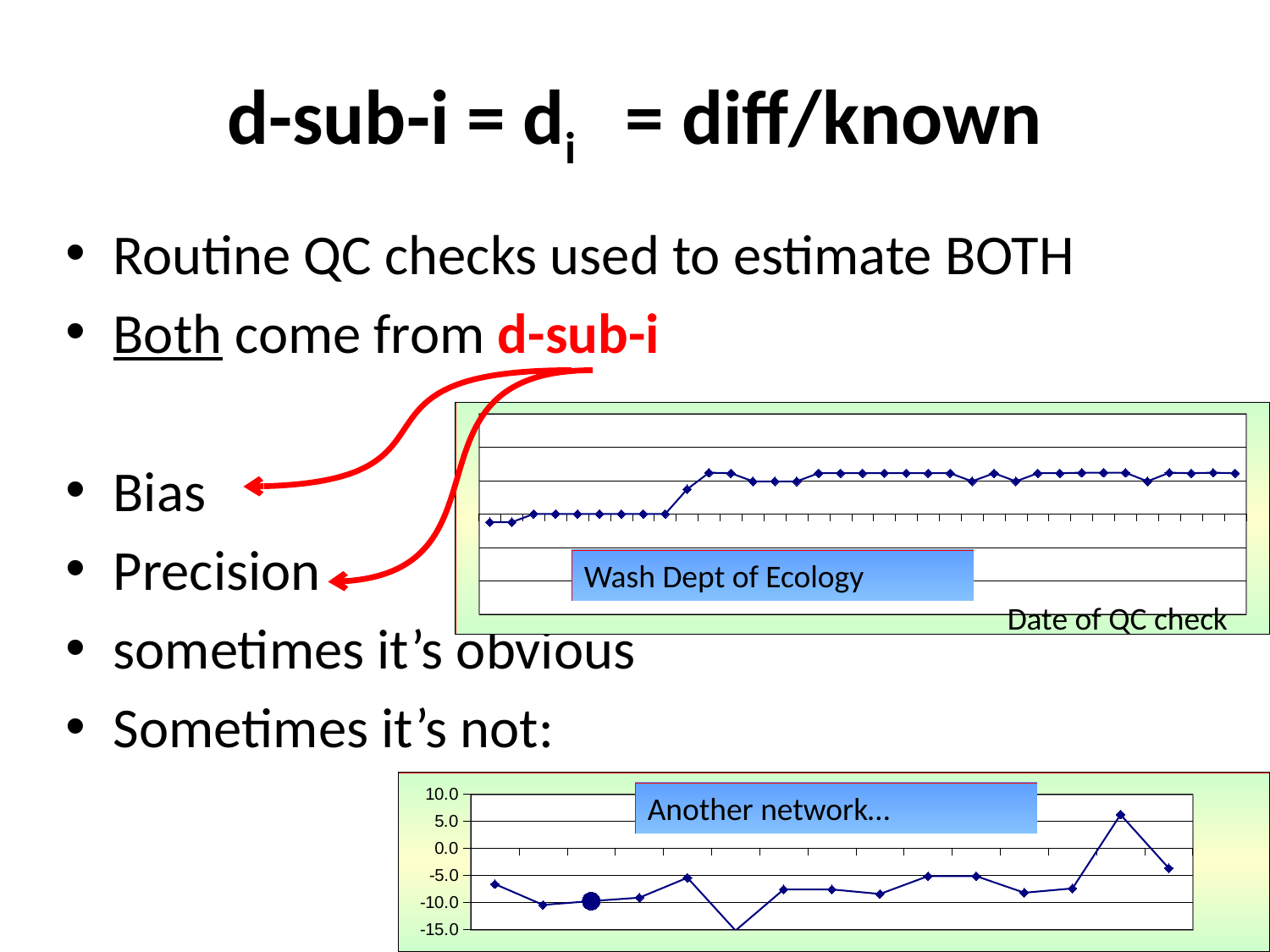
In the bottom chart labelled 'Another network...', how many plotted points are there? 15 In the bottom chart labelled 'Another network...', is the first plotted point greater or less than -5.0? less What text appears in the label box inside the bottom chart? Another network... In the bottom chart labelled 'Another network...', how many plotted points lie above 0.0? 1 In the top chart labelled 'Wash Dept of Ecology', do the plotted values rise or fall from left to right along the x axis? rise What kind of chart is the top chart labelled 'Wash Dept of Ecology'? line chart In the bottom chart labelled 'Another network...', is the last plotted point greater or less than 0.0? less What is the x-axis label of the top chart? Date of QC check In the bottom chart labelled 'Another network...', is the highest plotted point greater or less than 5.0? greater What kind of chart is the bottom chart labelled 'Another network...'? line chart